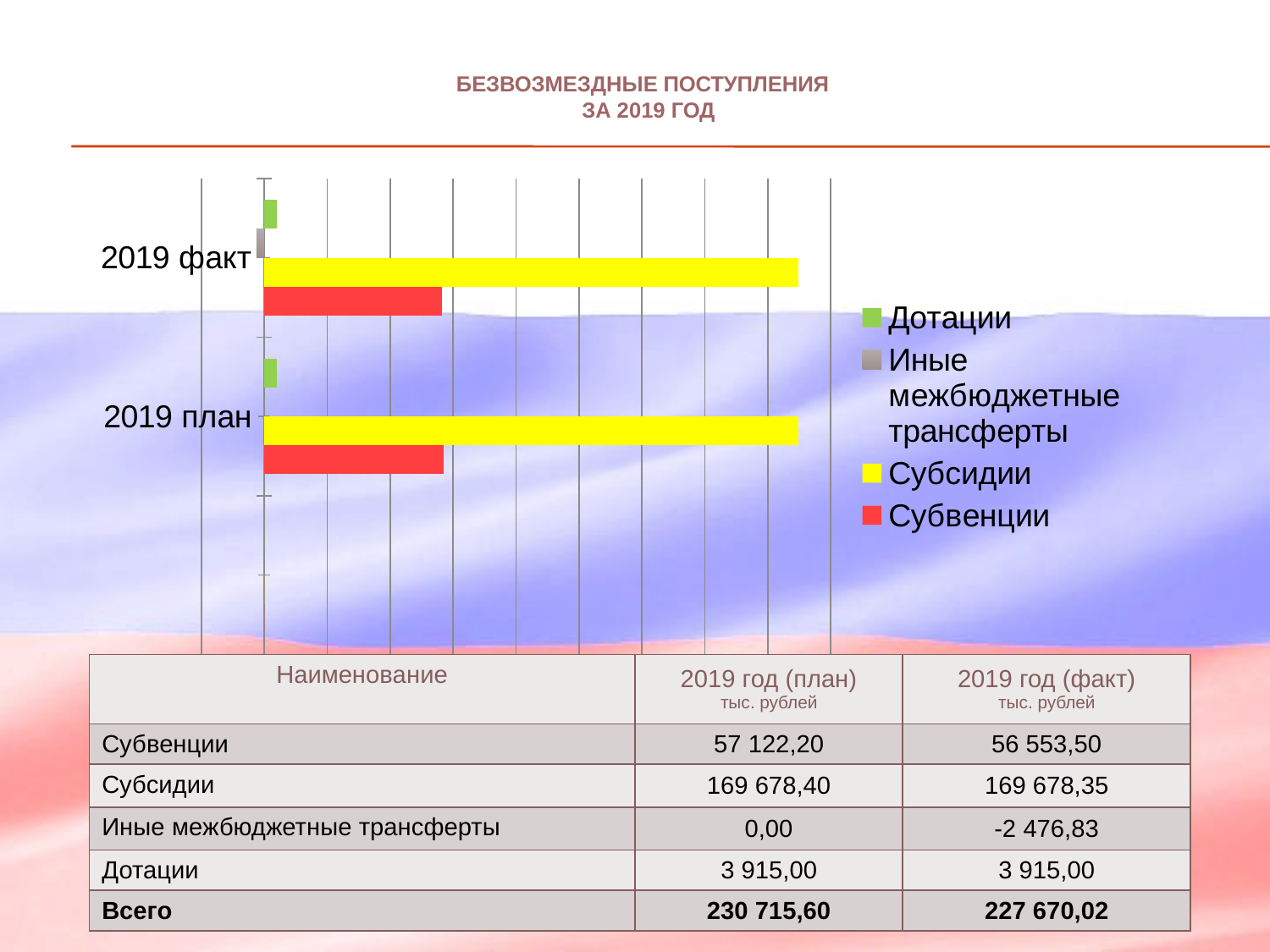
What kind of chart is shown on the slide? bar chart What is the total (Всего) for 2019 год (план), in тыс. рублей? 230 715,60 What is the value of Субвенции for 2019 год (факт), in тыс. рублей? 56 553,50 Which series has the longest bar for 2019 факт? Субсидии Is the bar for Субвенции or the bar for Дотации longer in 2019 план? Субвенции What is the value of Субсидии for 2019 год (факт), in тыс. рублей? 169 678,35 How many series does the chart legend list? 4 What is the value of Иные межбюджетные трансферты for 2019 год (факт), in тыс. рублей? -2 476,83 How many categories are shown on the chart's vertical axis? 2 What is the value of Субвенции for 2019 год (план), in тыс. рублей? 57 122,20 What colour represents Субсидии in the chart legend? yellow Which series has the longest bar for 2019 план? Субсидии